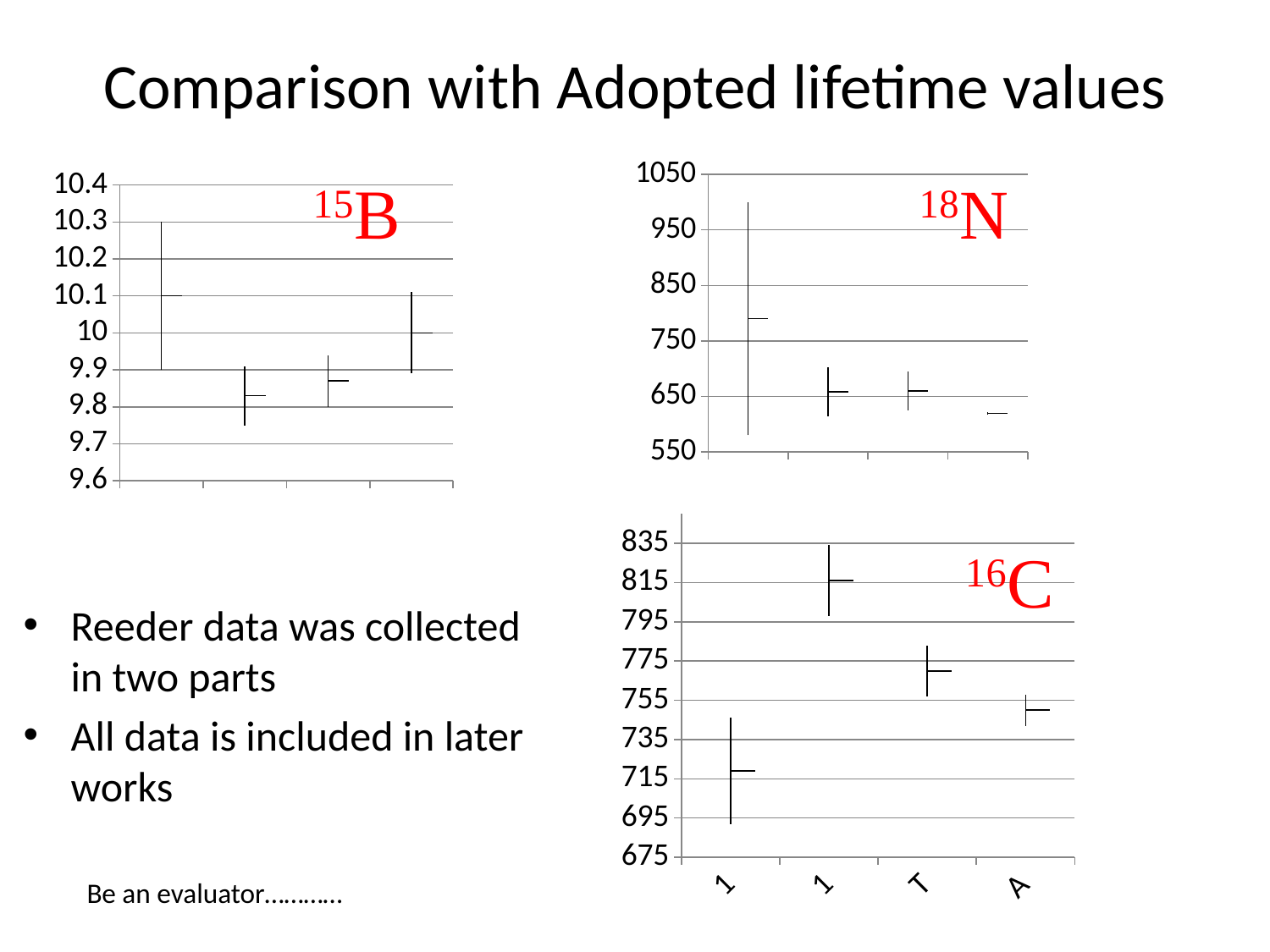
In the 16C chart, is the central value of the second point from the left greater or less than 795? greater In the 16C chart, which point has the lowest central value? the first (leftmost) point In the 18N chart, how many data points are plotted? 4 How many charts are shown on the slide? 3 In the 18N chart, which point has the lowest central value? the fourth (rightmost) point What red label is printed on the chart in the top-left of the slide? 15B In the 15B chart, is the central value of the second point from the left greater or less than 9.9? less In the 15B chart, is the central value of the first (leftmost) point greater or less than 10? greater In the 18N chart, which point has the highest central value? the first (leftmost) point In the 16C chart, how many data points are plotted? 4